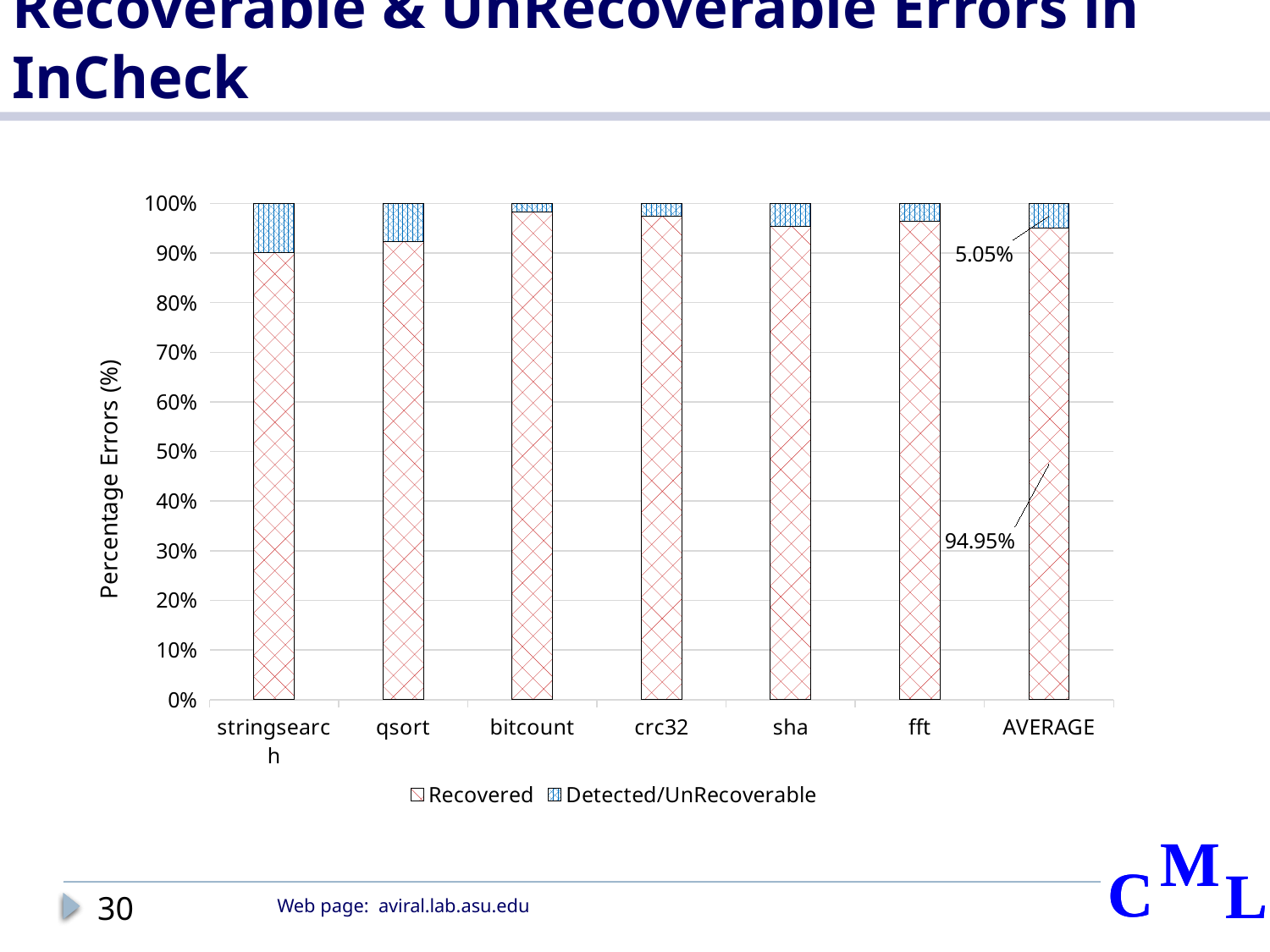
Which category has the largest Detected/UnRecoverable share? stringsearch Which category has the lowest Recovered share? stringsearch What is the Detected/UnRecoverable value for AVERAGE? 5.05% What is the total of the stacked bar for AVERAGE? 100% How many categories are shown on the x axis? 7 How many series does the legend list? 2 What is the label of the y axis? Percentage Errors (%) What is the Recovered value for AVERAGE? 94.95% Which has a larger Recovered share, stringsearch or bitcount? bitcount What kind of chart is shown on the slide? Stacked bar chart Is the Recovered value for bitcount greater or less than 95%? greater Is the Recovered value for stringsearch greater or less than 95%? less